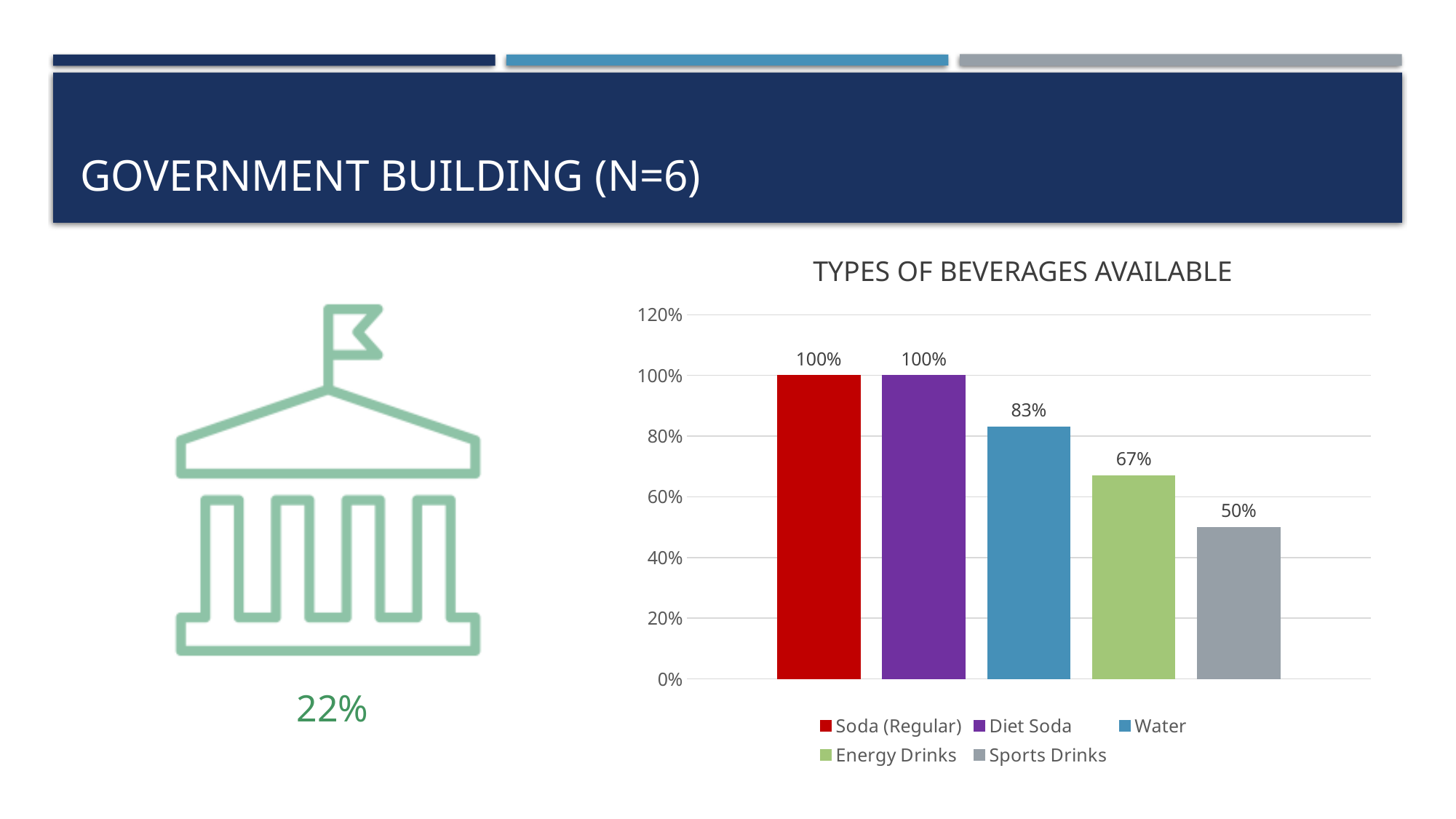
What is the value for Sports Drinks in the Types of Beverages Available chart? 50% How many beverage types are plotted in the Types of Beverages Available chart? 5 What is the value for Water in the Types of Beverages Available chart? 83% What colour is the Diet Soda bar in the Types of Beverages Available chart? Purple What is the value for Energy Drinks in the Types of Beverages Available chart? 67% What is the value for Diet Soda in the Types of Beverages Available chart? 100% Which beverage type has the lowest value in the Types of Beverages Available chart? Sports Drinks What is the difference between the values for Soda (Regular) and Energy Drinks in the Types of Beverages Available chart? 33% Which is larger in the Types of Beverages Available chart, the value for Water or the value for Energy Drinks? Water How many entries does the legend of the Types of Beverages Available chart list? 5 What is the difference between the values for Water and Sports Drinks in the Types of Beverages Available chart? 33% What kind of chart is the Types of Beverages Available chart? Bar chart